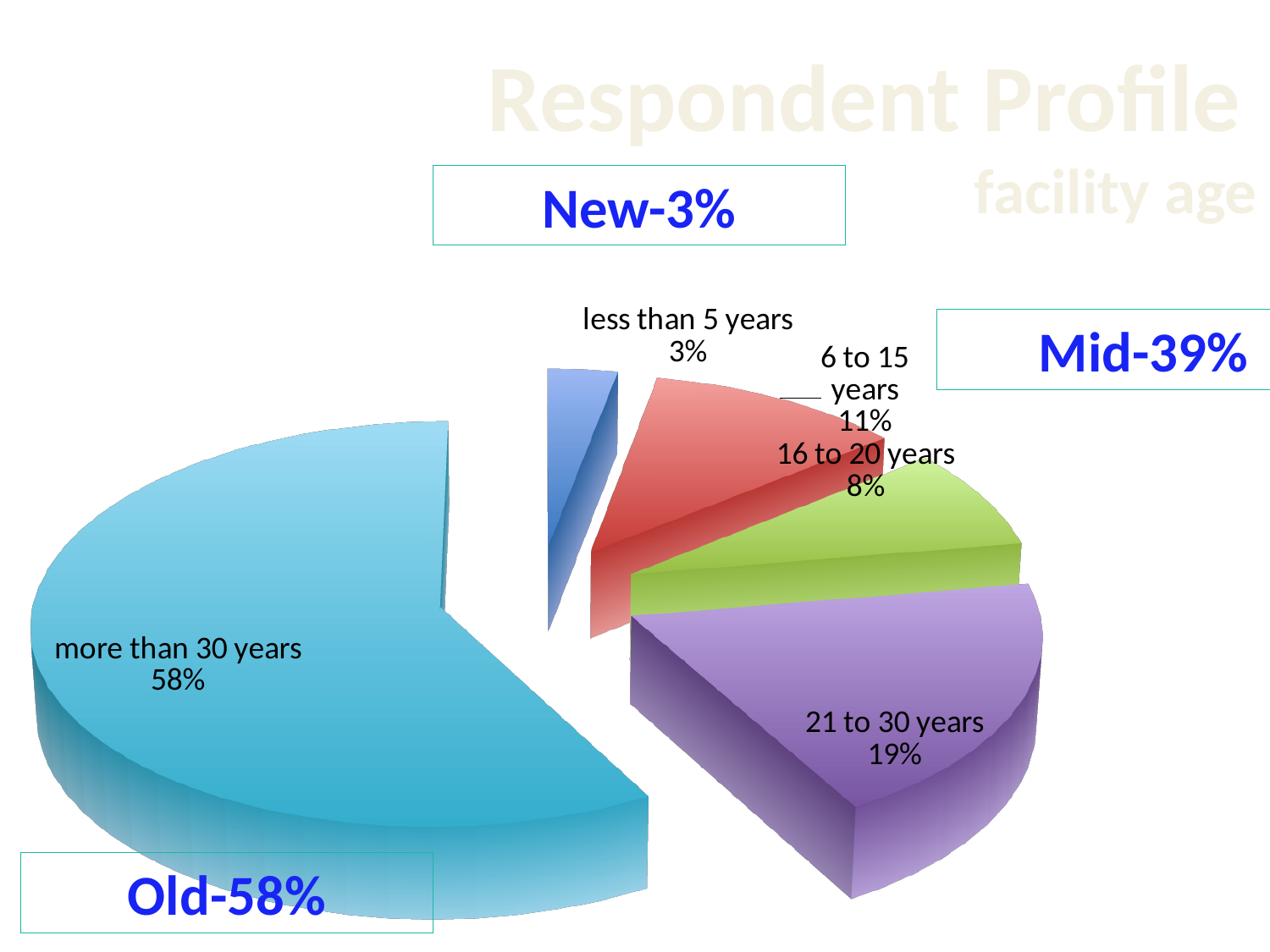
What percentage is shown for the 6 to 15 years slice? 11% Which facility age category has the smallest slice of the pie? less than 5 years What percentage is shown for the less than 5 years slice? 3% What percentage is shown for the 21 to 30 years slice? 19% What kind of chart is shown on the slide? pie chart What percentage is shown in the text box labelled 'Mid'? 39% Which facility age category has the largest slice of the pie? more than 30 years What percentage is shown for the 16 to 20 years slice? 8% Which slice is larger, 6 to 15 years or 16 to 20 years? 6 to 15 years What share of the pie is labelled for facilities aged more than 30 years? 58% What is the difference in percentage points between the 21 to 30 years slice and the 16 to 20 years slice? 11 How many slices does the pie chart have? 5